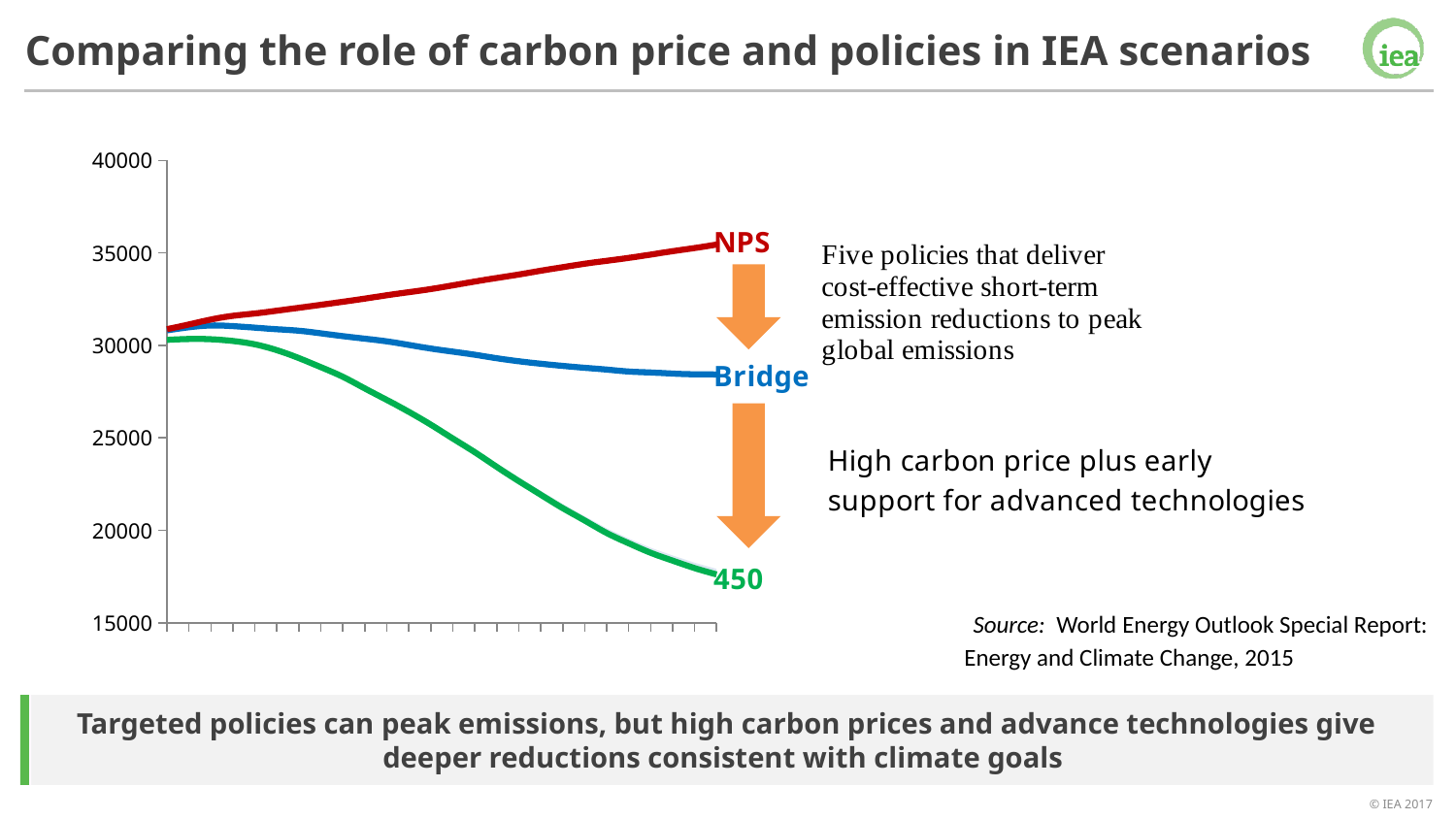
Does the 450 line rise or fall from left to right? fall What is the highest value shown on the vertical axis? 40000 At the right-hand end of the chart, is the Bridge line greater or less than 30000? less At the right-hand end of the chart, is the 450 line greater or less than 20000? less Which scenario line is lowest at the right-hand end of the chart? 450 How many scenario lines are plotted on the chart? 3 Which scenario line is highest at the right-hand end of the chart? NPS Does the NPS line rise or fall from left to right? rise At the right-hand end of the chart, is the NPS line greater or less than 30000? greater What kind of chart is shown on the slide? line chart At the right-hand end of the chart, which is higher, the Bridge line or the 450 line? Bridge What colour is the 450 line? green